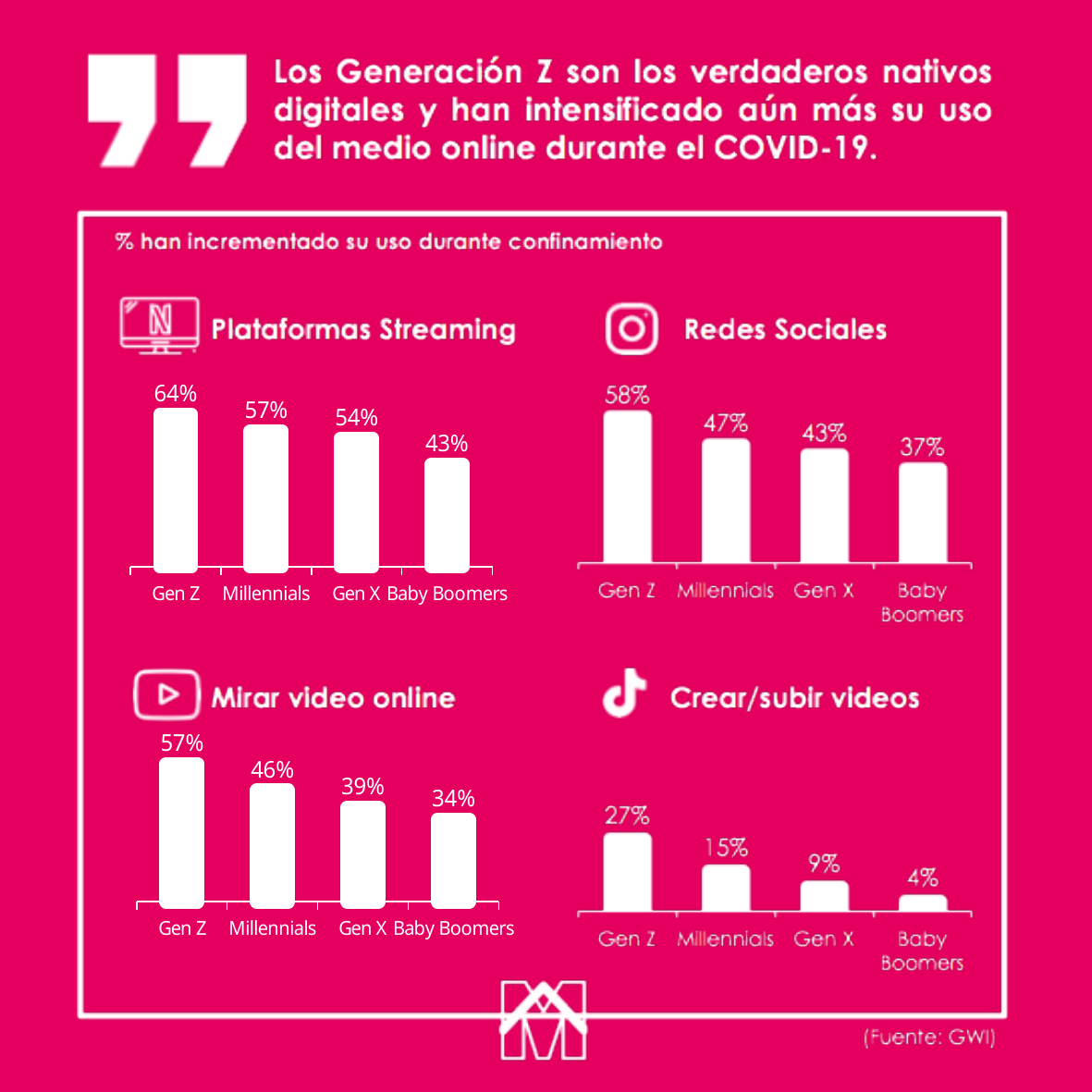
In the 'Mirar video online' chart, what is the value for Gen X? 39% In the 'Redes Sociales' chart, what is the value for Millennials? 47% In the 'Crear/subir videos' chart, what is the value for Baby Boomers? 4% In the 'Redes Sociales' chart, which category has the lowest value? Baby Boomers In the 'Plataformas Streaming' chart, what is the value for Gen Z? 64% What kind of chart is the 'Mirar video online' chart? Bar chart In the 'Plataformas Streaming' chart, do the values rise or fall from Gen Z to Baby Boomers? Fall In the 'Crear/subir videos' chart, which category has the highest value? Gen Z In the 'Mirar video online' chart, what is the difference between the values for Gen Z and Millennials? 11% In the 'Plataformas Streaming' chart, what is the difference between the values for Gen Z and Baby Boomers? 21% How many categories are shown in the 'Crear/subir videos' chart? 4 In the 'Redes Sociales' chart, which is larger: the value for Gen X or the value for Baby Boomers? Gen X